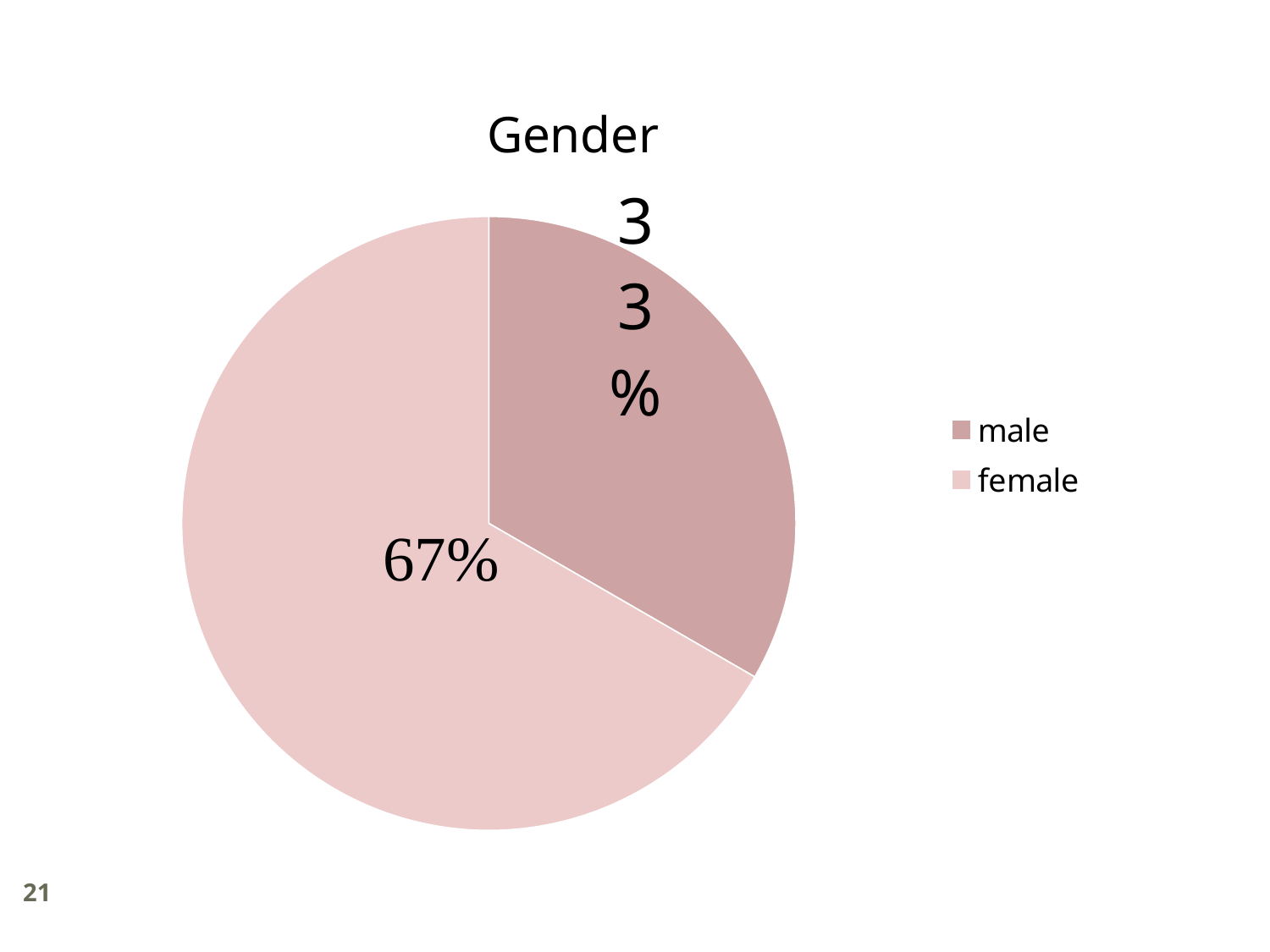
Which is larger, the male slice or the female slice? female What is the title of the chart? Gender What kind of chart is shown on the slide? pie chart Which slice is the largest in the pie chart? female How many entries does the legend list? 2 What is the difference in percentage points between the female and male slices? 34 Which legend entry is shown in the darker shade of pink? male How many slices does the pie chart have? 2 Which slice is the smallest in the pie chart? male What percentage of the pie is the male slice? 33% What percentage of the pie is the female slice? 67% What share of the pie does the female slice represent? 67%